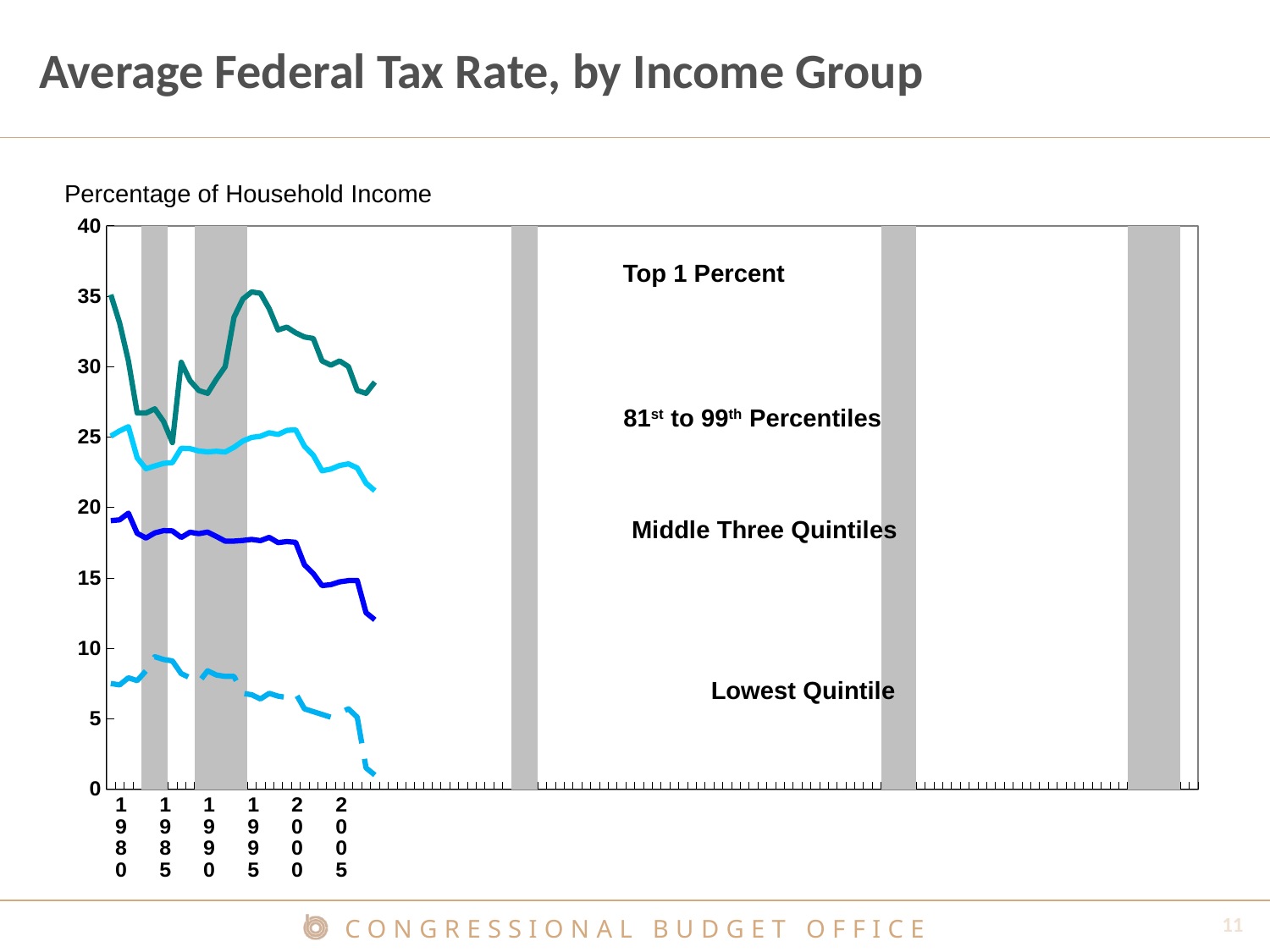
Is the value for the Middle Three Quintiles in 1980 greater or less than 20? less How many income groups (series) are plotted on the chart? 4 In 1990, which is larger: the value for the Top 1 Percent or the value for the Middle Three Quintiles? Top 1 Percent Which income group has the lowest average federal tax rate across the whole period? Lowest Quintile How many year labels are shown on the x axis? 6 What kind of chart is shown on the slide? line chart What is the title of the chart? Average Federal Tax Rate, by Income Group Is the value for the 81st to 99th Percentiles at the end of the series greater or less than 20? greater Does the value for the Middle Three Quintiles rise or fall from 1980 to the end of the series? fall Is the value for the Lowest Quintile in 1985 greater or less than 5? greater Which income group has the highest average federal tax rate across the whole period? Top 1 Percent